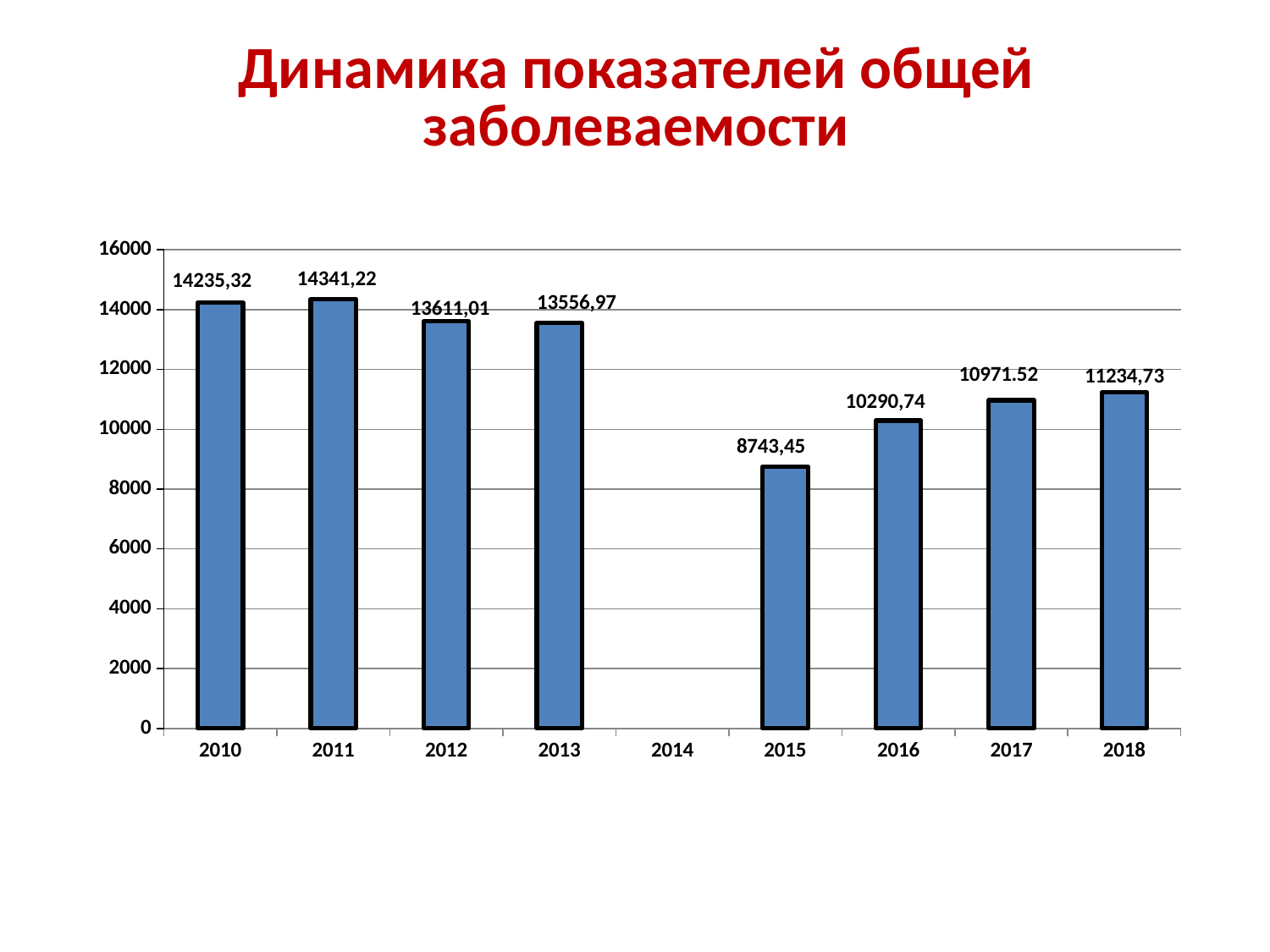
Which is larger, the value for 2012 or the value for 2016? 2012 How many bars are plotted on the chart? 8 Which year has the highest value? 2011 Is the value for 2015 greater or less than 10000? less What is the value for 2018? 11234,73 What kind of chart is shown on the slide? bar chart What is the value for 2010? 14235,32 Which year has the lowest value? 2015 What is the value for 2015? 8743,45 What is the difference between the values for 2016 and 2015? 1547,29 What is the difference between the values for 2018 and 2017? 263,21 Do the values rise or fall from 2015 to 2018? rise